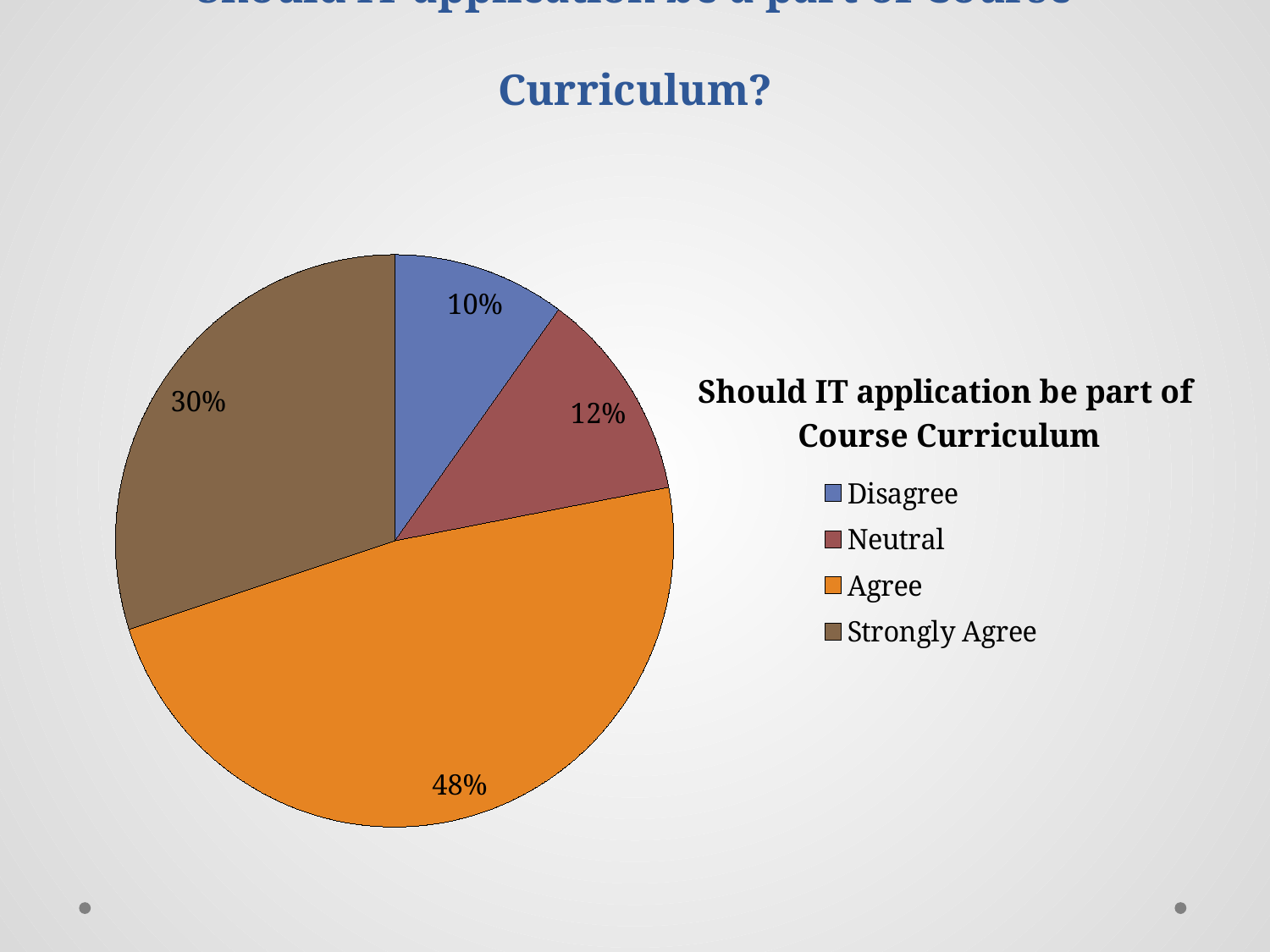
Which response has the largest share of the pie? Agree How many response categories are shown in the pie chart? 4 What is the combined share of Agree and Strongly Agree? 78% What colour is the Agree slice in the pie chart? Orange What percentage of respondents chose Neutral? 12% What percentage of respondents chose Disagree? 10% What percentage of respondents chose Agree? 48% What is the difference in percentage points between Agree and Strongly Agree? 18 What percentage of respondents chose Strongly Agree? 30% What kind of chart is shown on the slide? Pie chart Which response has the smallest share of the pie? Disagree Which is larger, the share for Neutral or the share for Disagree? Neutral